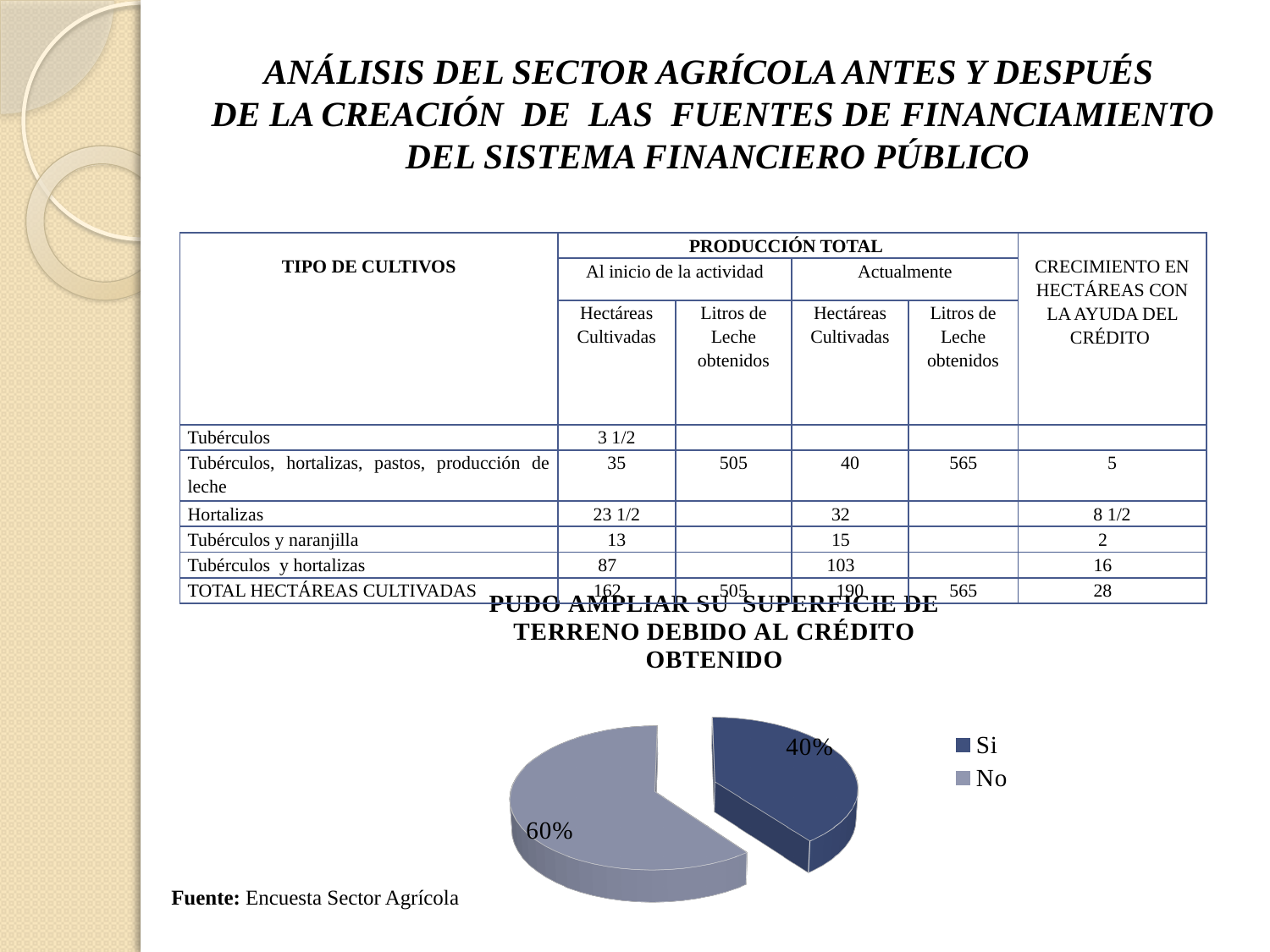
In the pie chart, which is larger, the "Si" slice or the "No" slice? No In the pie chart, what share is labelled for "Si"? 40% Which slice of the pie chart is the largest? No What kind of chart is shown on the slide? Pie chart In the pie chart, what share is labelled for "No"? 60% What is the difference in percentage points between the "No" and "Si" slices of the pie chart? 20% How many slices does the pie chart have? 2 Which legend entry of the pie chart is shown in dark blue? Si Which slice of the pie chart is the smallest? Si How many entries does the pie chart's legend list? 2 What is the title of the pie chart? PUDO AMPLIAR SU SUPERFICIE DE TERRENO DEBIDO AL CRÉDITO OBTENIDO